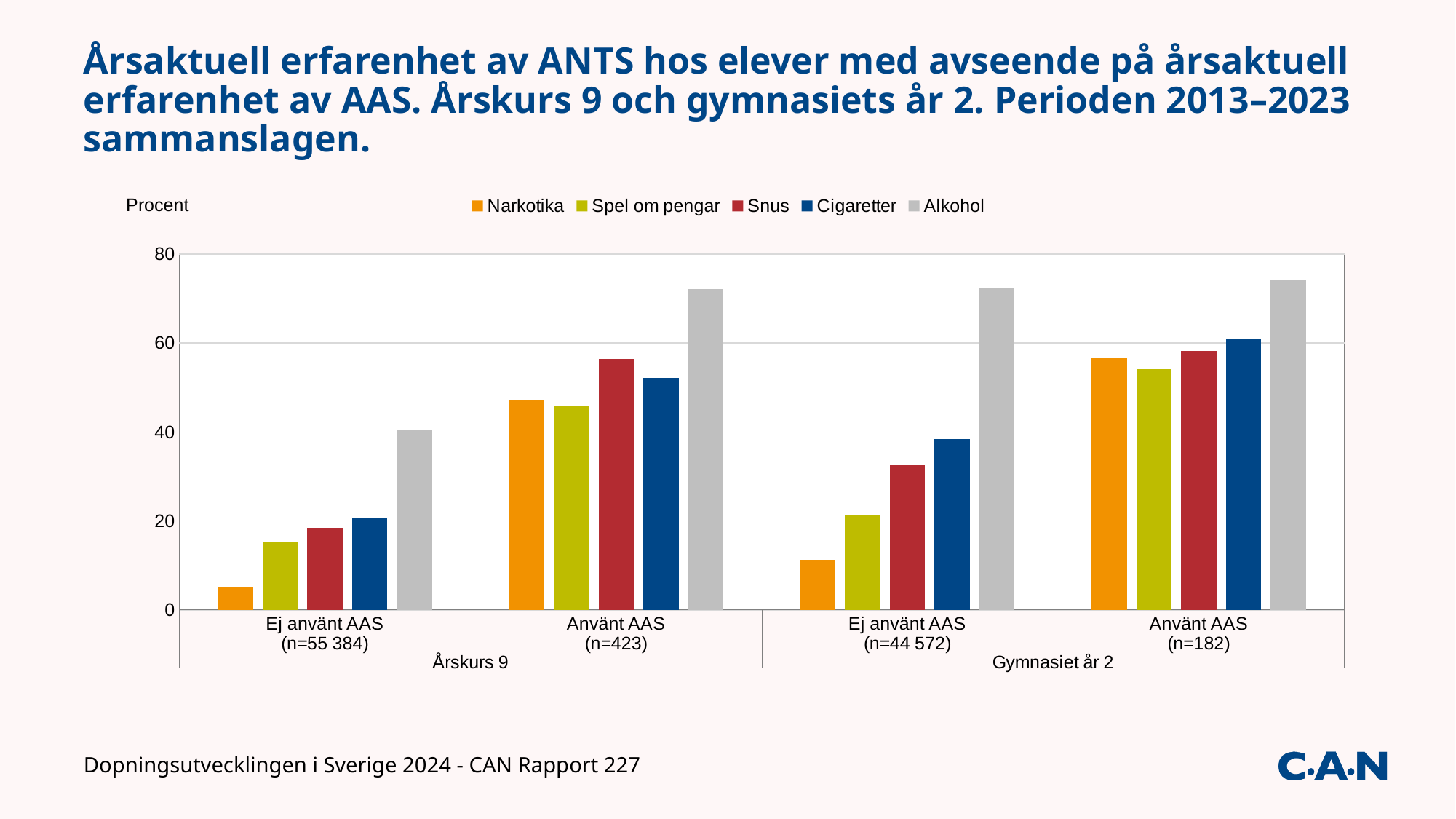
What is the label on the vertical axis of the chart? Procent How many series does the legend list? 5 For Alkohol among Ej använt AAS, which group has the larger value: Årskurs 9 or Gymnasiet år 2? Gymnasiet år 2 Is the value for Cigaretter among Ej använt AAS in Gymnasiet år 2 greater or less than 40? less For Använt AAS in Årskurs 9, which is larger: Snus or Cigaretter? Snus Is the value for Narkotika among Ej använt AAS in Gymnasiet år 2 greater or less than 20? less Is the value for Alkohol among Använt AAS in Årskurs 9 greater or less than 60? greater Which series has the lowest value for Ej använt AAS (n=55 384) in Årskurs 9? Narkotika What kind of chart is shown on the slide? Bar chart How many category groups are shown along the x axis? 4 Which series has the highest value for Använt AAS (n=182) in Gymnasiet år 2? Alkohol